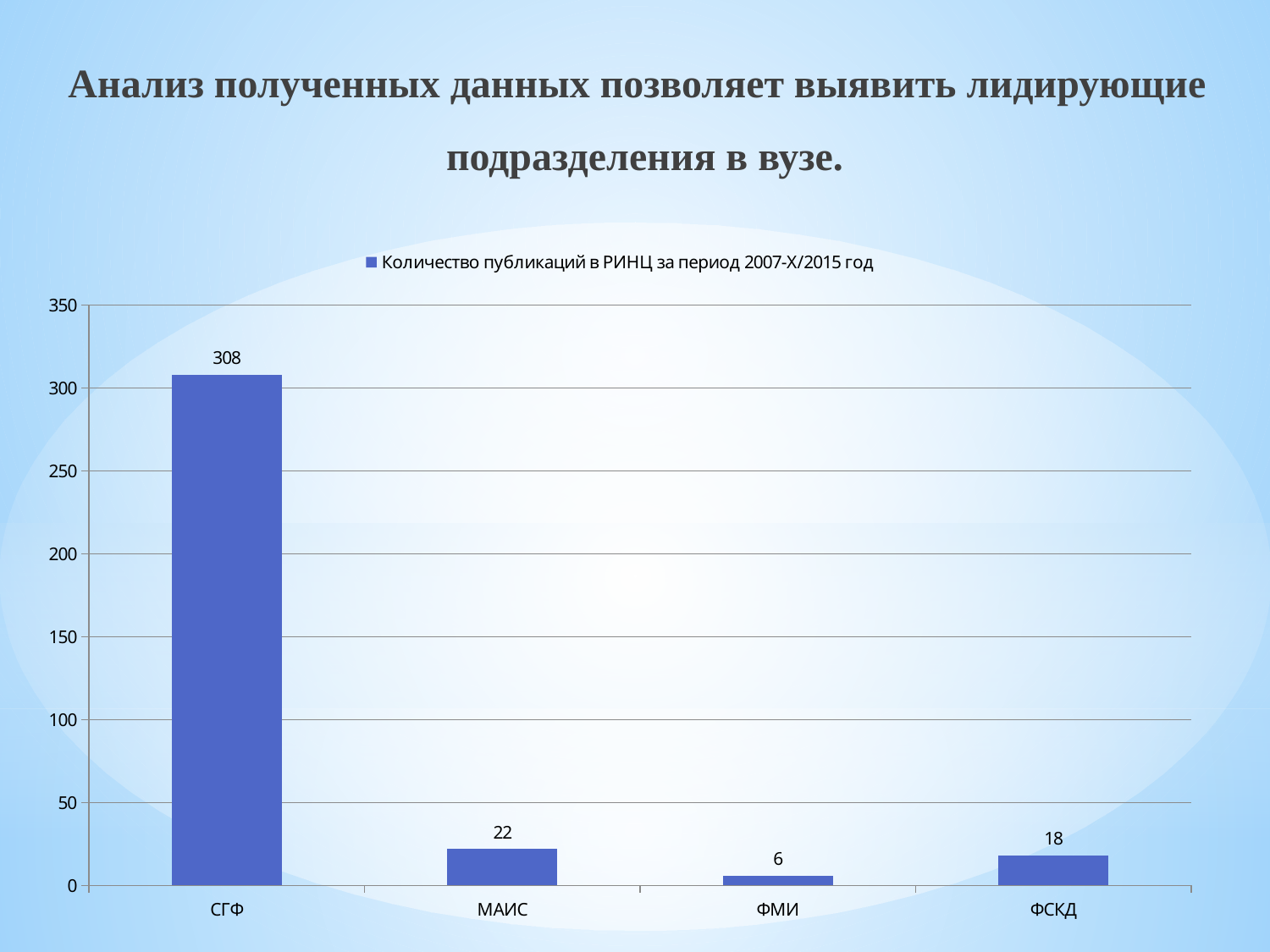
What is the series name shown in the legend? Количество публикаций в РИНЦ за период 2007-X/2015 год What kind of chart is shown on the slide? Bar chart Which category has the lowest value? ФМИ What is the difference between the values for СГФ and МАИС? 286 How many categories are shown on the x axis? 4 What is the value for ФСКД? 18 What is the value for ФМИ? 6 What is the value for СГФ? 308 Which category has the highest value? СГФ What is the difference between the values for МАИС and ФСКД? 4 What is the value for МАИС? 22 Which is larger, the value for МАИС or the value for ФСКД? МАИС